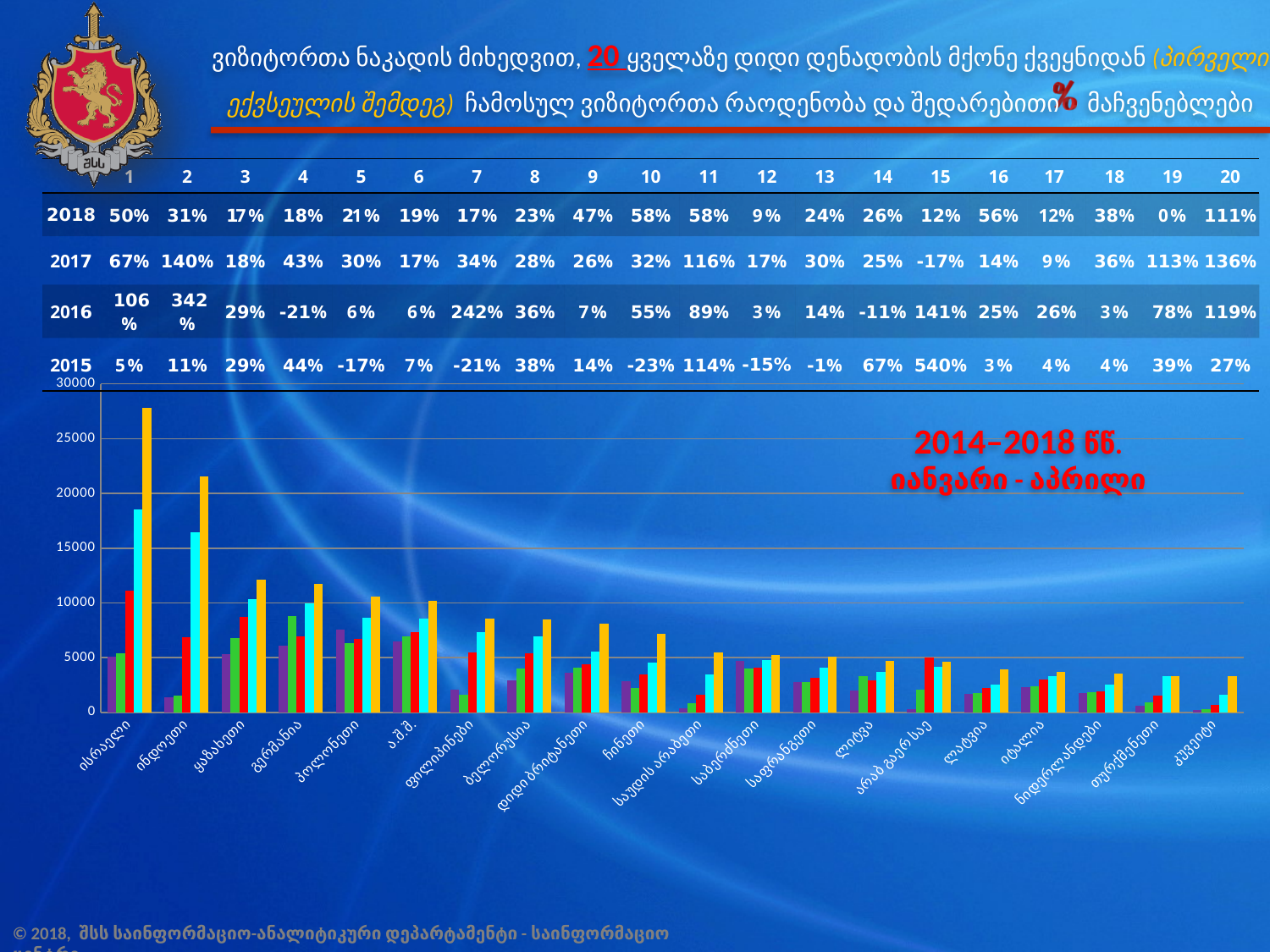
Do the bar heights generally rise or fall moving from left to right along the x axis? fall How many bars are plotted for each country in the bar chart? 5 Is the tallest bar for ჩინეთი greater or less than 10000? less How many countries (categories) are shown on the x axis of the bar chart? 20 What period is written in red text inside the chart area? 2014-2018 წწ. იანვარი - აპრილი Which country has the tallest bar in the chart? ისრაელი Is the tallest bar for ისრაელი greater or less than 25000? greater Is the tallest bar for ინდოეთი greater or less than 20000? greater What kind of chart is shown on the slide? bar chart What is the highest value shown on the y axis of the bar chart? 30000 Which country has a taller tallest bar, ისრაელი or ყაზახეთი? ისრაელი